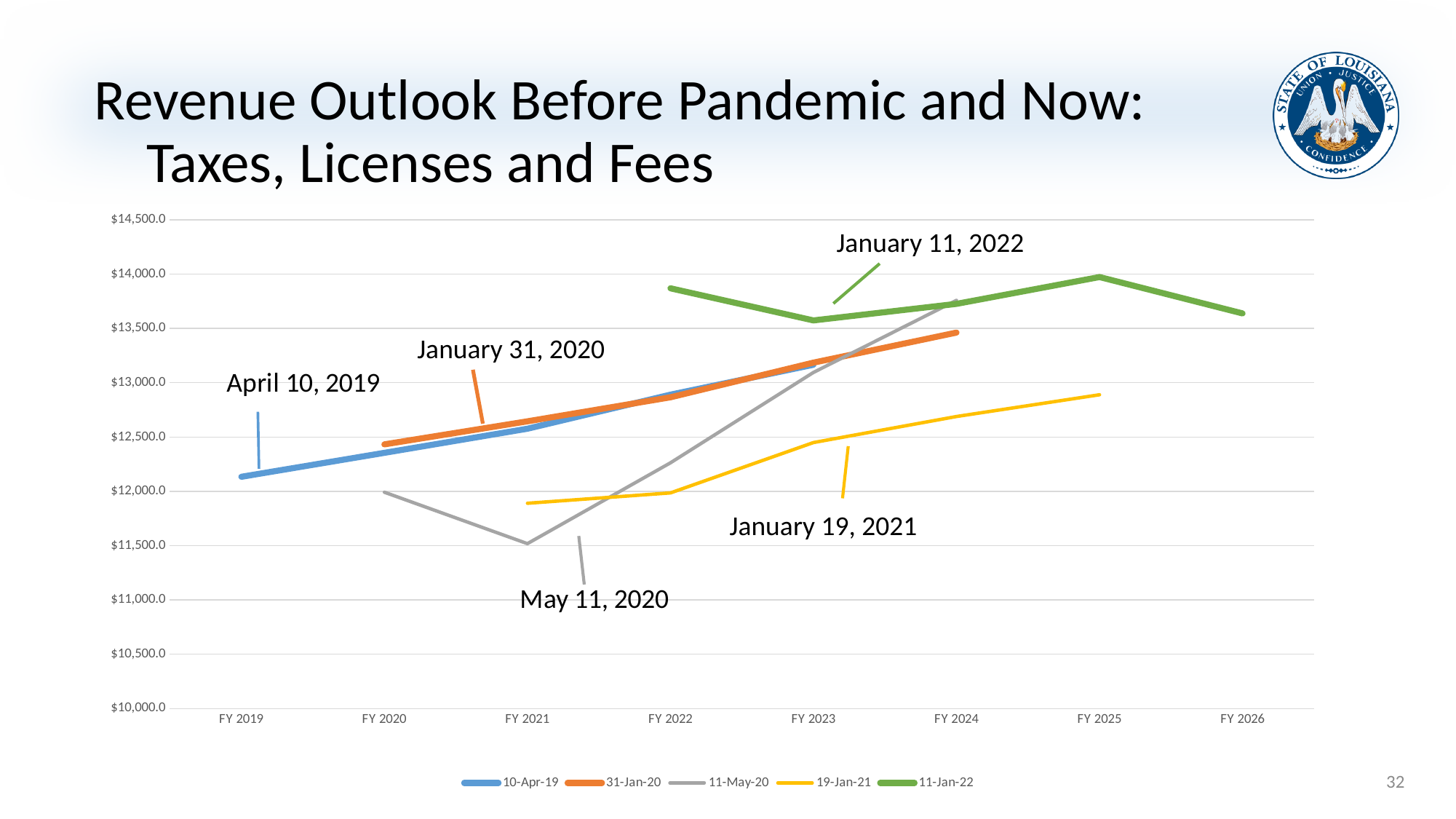
Is the value for the 11-Jan-22 series at FY 2022 greater or less than $13,500.0? greater How many fiscal years are shown on the x axis? 8 Which forecast date is annotated next to the green line? January 11, 2022 Is the value for the 19-Jan-21 series at FY 2025 greater or less than $12,500.0? greater How many series does the legend list? 5 Which series has the highest value at FY 2022? 11-Jan-22 Is the value for the 10-Apr-19 series at FY 2019 greater or less than $12,500.0? less At FY 2023, which series is higher: 11-Jan-22 or 19-Jan-21? 11-Jan-22 Which series has the lowest value at FY 2021? 11-May-20 What kind of chart is shown on the slide? line chart Does the 19-Jan-21 series rise or fall from FY 2021 to FY 2025? rise